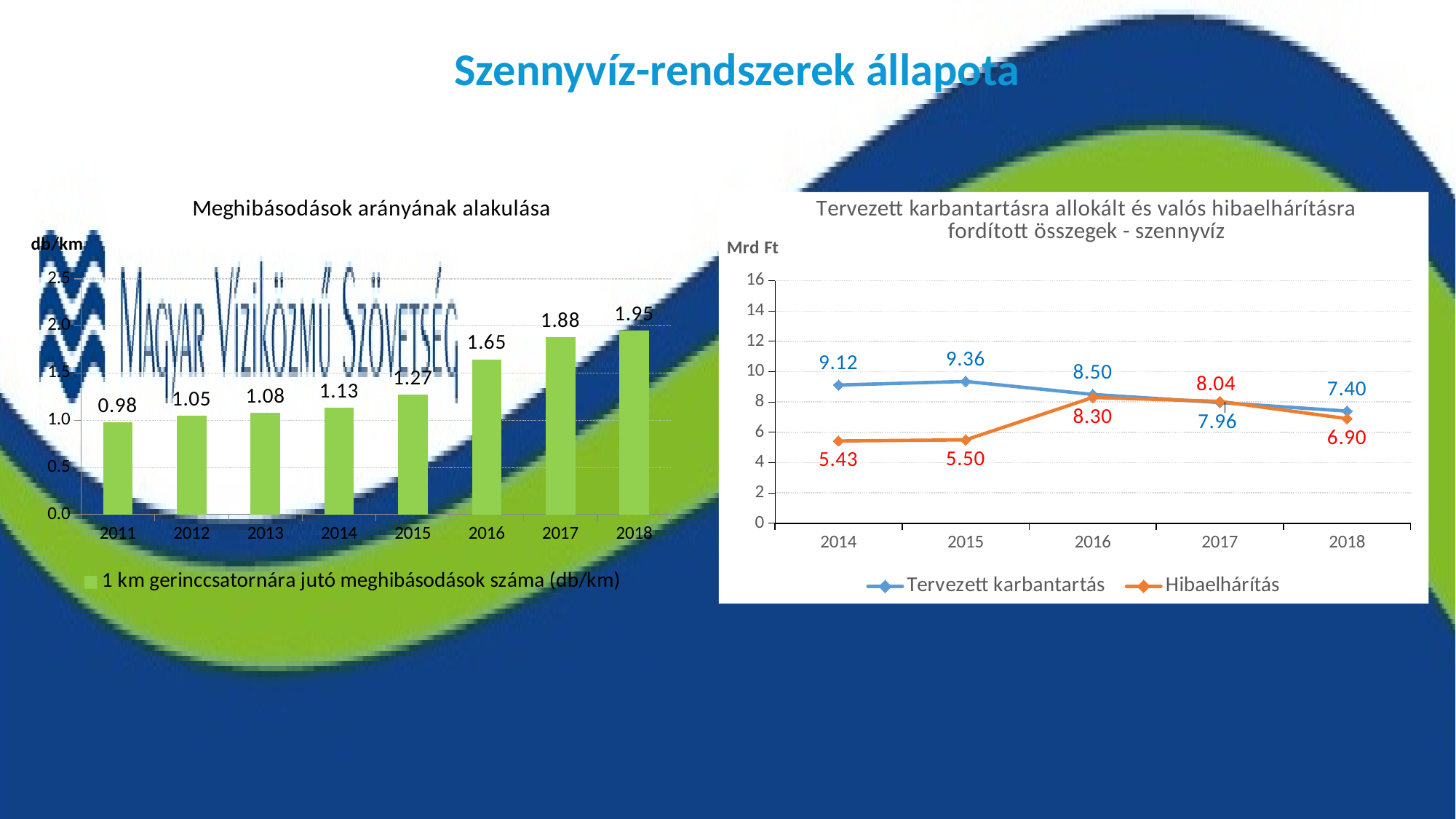
In the chart 'Meghibásodások arányának alakulása', which year has the highest value? 2018 In the right-hand chart 'Tervezett karbantartásra allokált és valós hibaelhárításra fordított összegek - szennyvíz', what is the difference between Tervezett karbantartás and Hibaelhárítás in 2014? 3.69 In the right-hand chart 'Tervezett karbantartásra allokált és valós hibaelhárításra fordított összegek - szennyvíz', what is the value of Tervezett karbantartás in 2015? 9.36 In the chart 'Meghibásodások arányának alakulása', what is the difference between the values for 2018 and 2011? 0.97 In the chart 'Meghibásodások arányának alakulása', do the values rise or fall from 2011 to 2018? rise What kind of chart is 'Meghibásodások arányának alakulása'? bar chart In the chart 'Meghibásodások arányának alakulása', how many years are shown on the x axis? 8 How many series does the legend of the right-hand chart 'Tervezett karbantartásra allokált és valós hibaelhárításra fordított összegek - szennyvíz' list? 2 In the chart 'Meghibásodások arányának alakulása', what is the value for 2016? 1.65 In the right-hand chart 'Tervezett karbantartásra allokált és valós hibaelhárításra fordított összegek - szennyvíz', what is the value of Hibaelhárítás in 2016? 8.30 In the chart 'Meghibásodások arányának alakulása', which year has the lowest value? 2011 In the right-hand chart 'Tervezett karbantartásra allokált és valós hibaelhárításra fordított összegek - szennyvíz', which series has the larger value in 2017? Hibaelhárítás